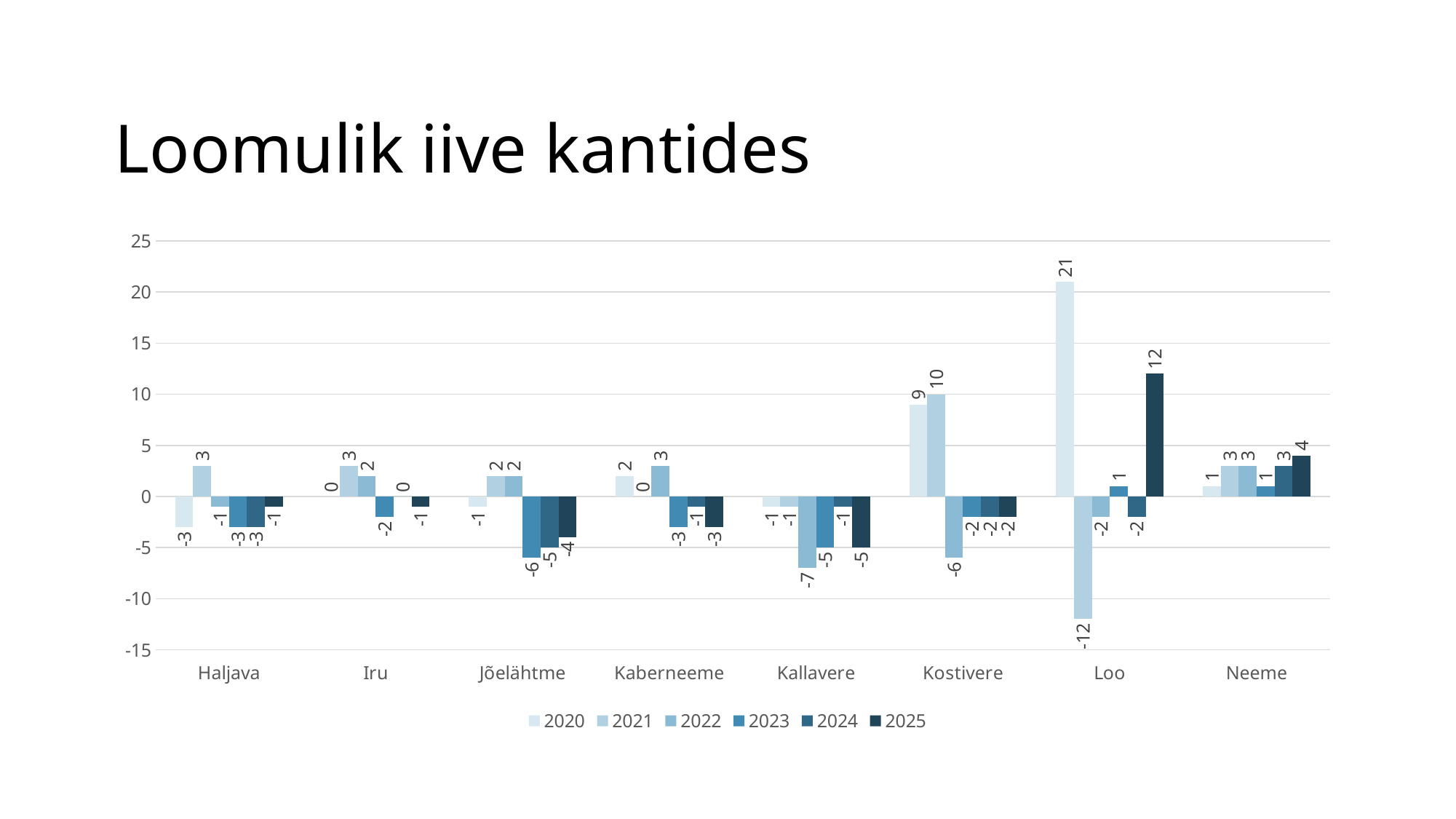
What is the difference between the 2020 and 2021 values for Loo? 33 How many series does the legend list? 6 What is the value for Kostivere in 2021? 10 Which category has the highest value in 2025? Loo What is the value for Kallavere in 2022? -7 Which is larger, the 2023 value for Jõelähtme or the 2023 value for Kaberneeme? Kaberneeme What type of chart is shown on the slide? bar chart Do the values for Neeme rise or fall from 2024 to 2025? rise Which category has the lowest value in 2021? Loo What is the title of the chart? Loomulik iive kantides How many categories are shown on the x axis? 8 What is the value for Loo in 2020? 21